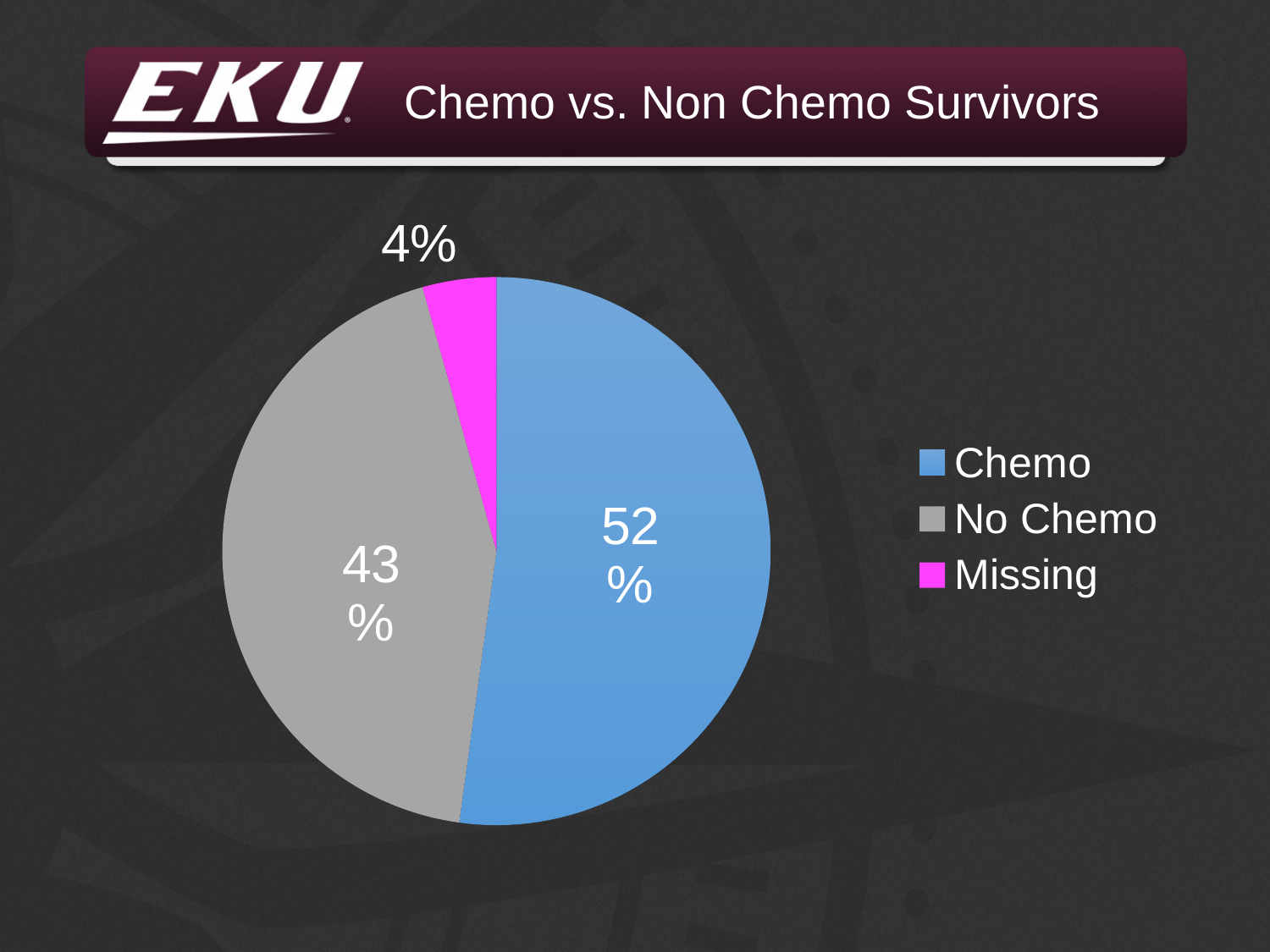
What colour is the Missing slice? Magenta Which category has the smallest share of the pie? Missing What is the difference in percentage points between the Chemo and No Chemo slices? 9 How many categories does the pie chart show? 3 What is the title of the slide? Chemo vs. Non Chemo Survivors Which slice is larger, Chemo or No Chemo? Chemo What percentage of survivors is labelled Missing? 4% What percentage of survivors did not receive chemo? 43% What kind of chart is shown on the slide? Pie chart Which category has the largest share of the pie? Chemo How many entries does the legend list? 3 What percentage of survivors received chemo? 52%